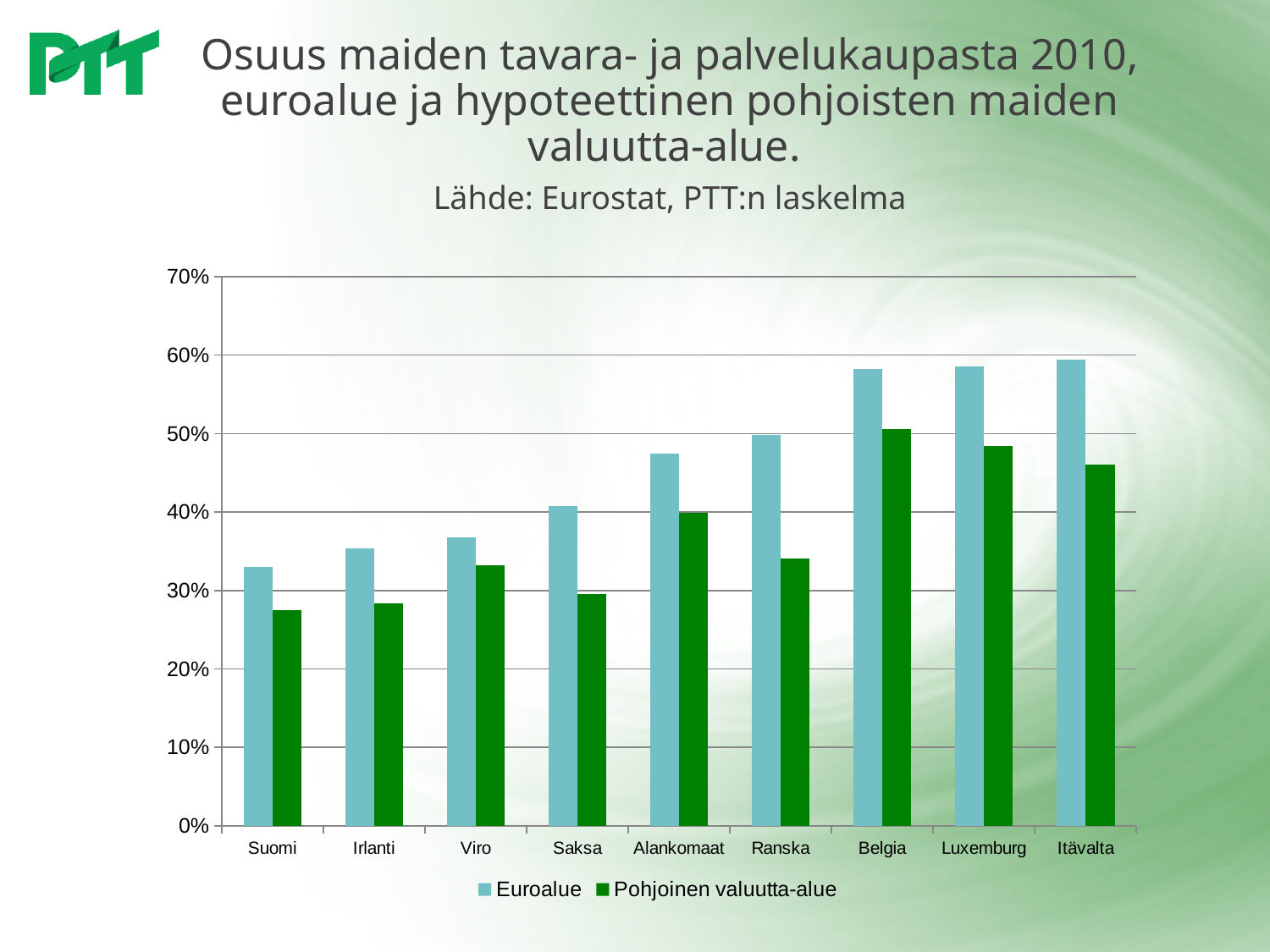
How many series does the legend list? 2 Is the Pohjoinen valuutta-alue value for Itävalta greater or less than 50%? less Which country has the highest value for the Pohjoinen valuutta-alue series? Belgia What kind of chart is shown on the slide? bar chart Is the Euroalue value for Belgia greater or less than 50%? greater Which has the larger Euroalue value, Saksa or Ranska? Ranska For Ranska, which series has the larger value, Euroalue or Pohjoinen valuutta-alue? Euroalue Which country has the lowest value for the Euroalue series? Suomi How many countries are shown on the x axis of the chart? 9 Is the Euroalue value for Suomi greater or less than 30%? greater Do the Euroalue values generally rise or fall from Suomi to Itävalta along the x axis? rise